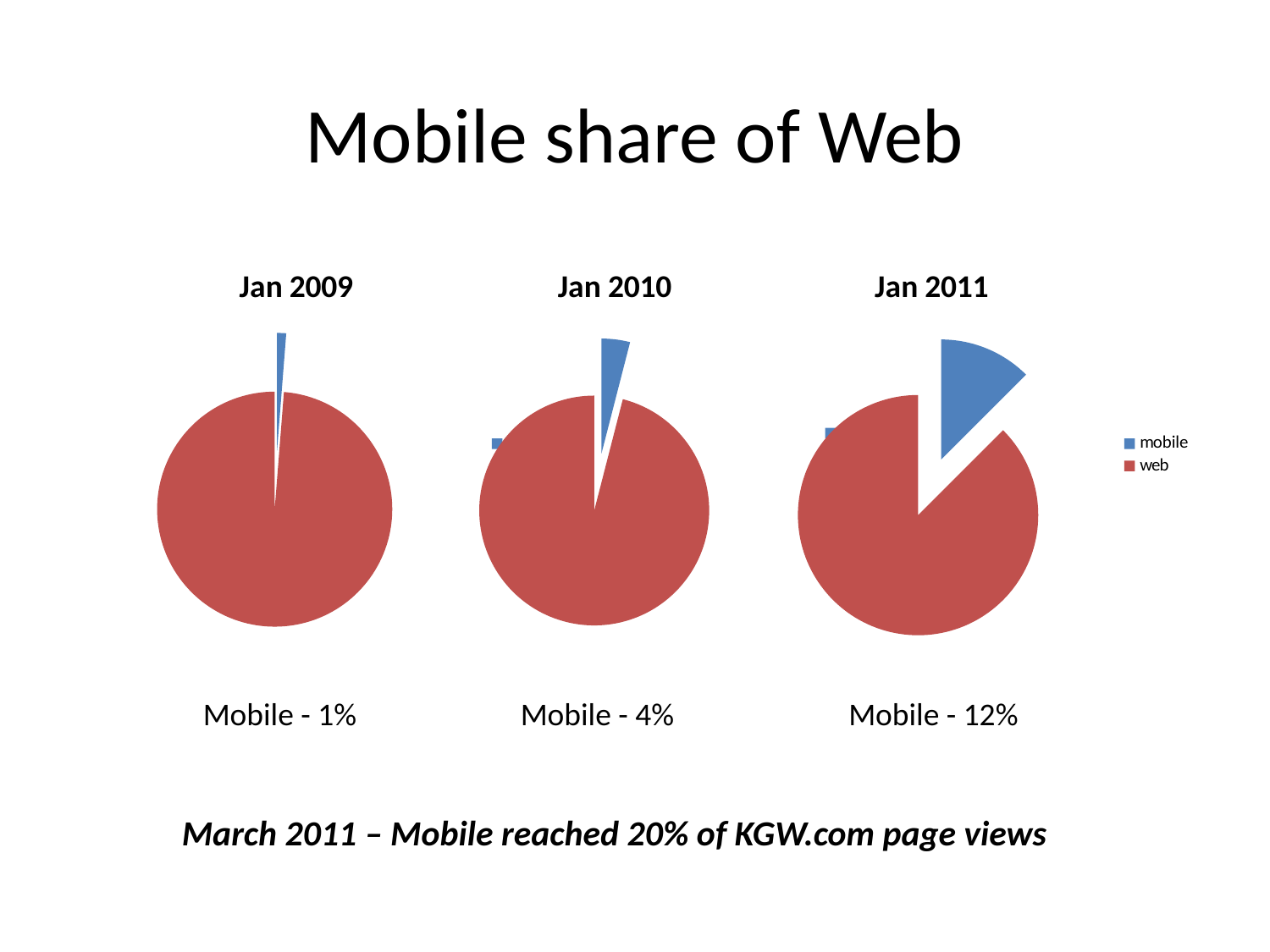
Does the mobile share rise or fall from Jan 2009 to Jan 2011 across the three pie charts? Rise Which of the three pie charts shows the smallest mobile share? Jan 2009 Is the mobile share larger in the Jan 2010 pie chart or the Jan 2009 pie chart? Jan 2010 How many series does the legend list? 2 How many pie charts are on the slide? 3 Which of the three pie charts shows the largest mobile share? Jan 2011 In the Jan 2010 pie chart, what share does mobile have? 4% In the Jan 2011 pie chart, what share does mobile have? 12% In the Jan 2009 pie chart, what share does mobile have? 1% By how many percentage points did the mobile share grow from Jan 2010 to Jan 2011? 8 What kind of charts are shown on the slide? Pie charts What are the two entries in the legend? mobile, web